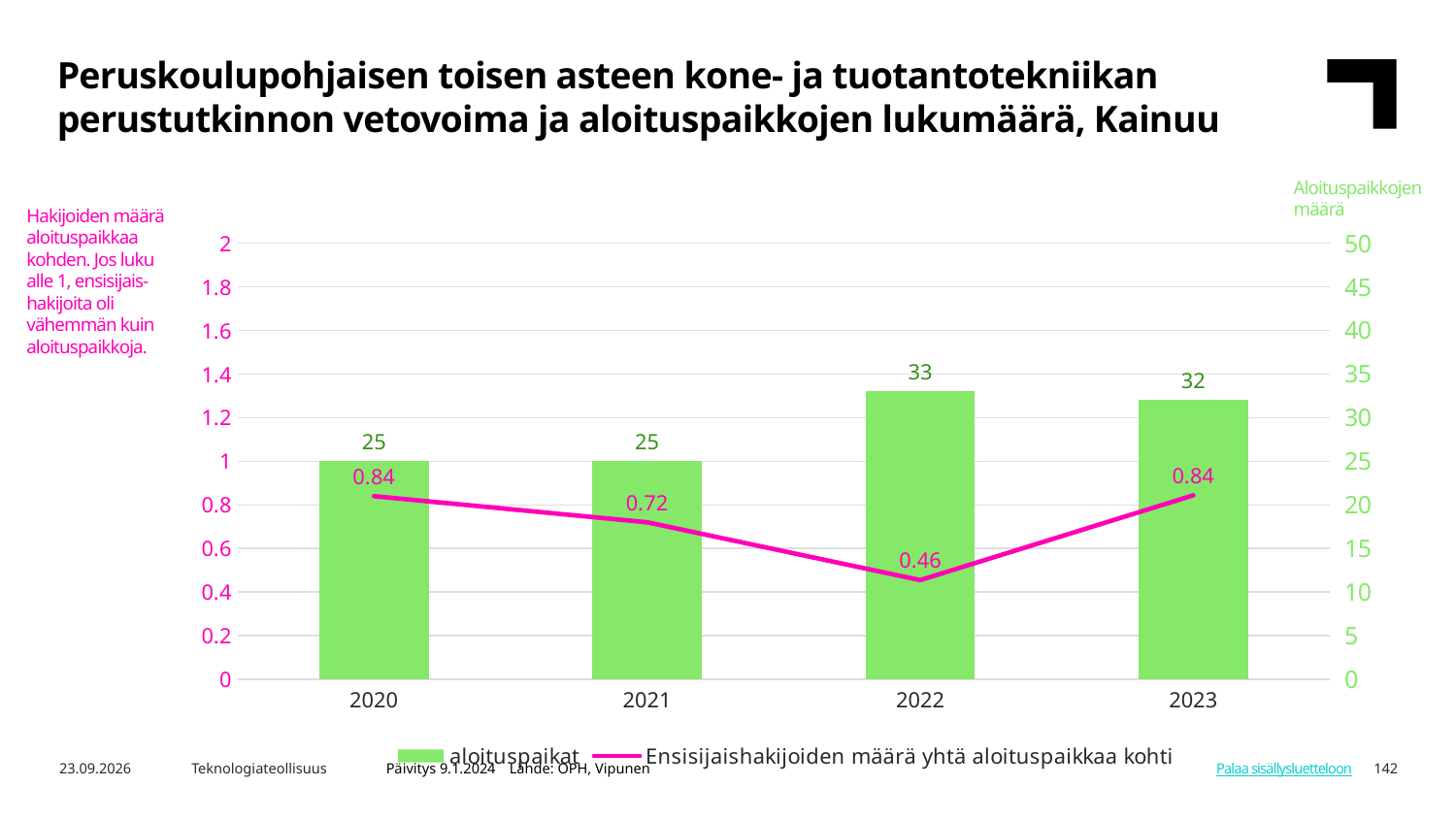
How many aloituspaikat were there in 2022? 33 Is the value of Ensisijaishakijoiden määrä yhtä aloituspaikkaa kohti in 2020 greater or less than 1? less Does Ensisijaishakijoiden määrä yhtä aloituspaikkaa kohti rise or fall from 2020 to 2022? fall How many years are shown on the x axis? 4 What is the difference in aloituspaikat between 2022 and 2020? 8 Which year has more aloituspaikat, 2022 or 2023? 2022 In which year is Ensisijaishakijoiden määrä yhtä aloituspaikkaa kohti lowest? 2022 How many series does the legend list? 2 What is the value of Ensisijaishakijoiden määrä yhtä aloituspaikkaa kohti in 2021? 0.72 What is the value of Ensisijaishakijoiden määrä yhtä aloituspaikkaa kohti in 2022? 0.46 In which year is the number of aloituspaikat highest? 2022 What kind of chart is used to show aloituspaikat? bar chart